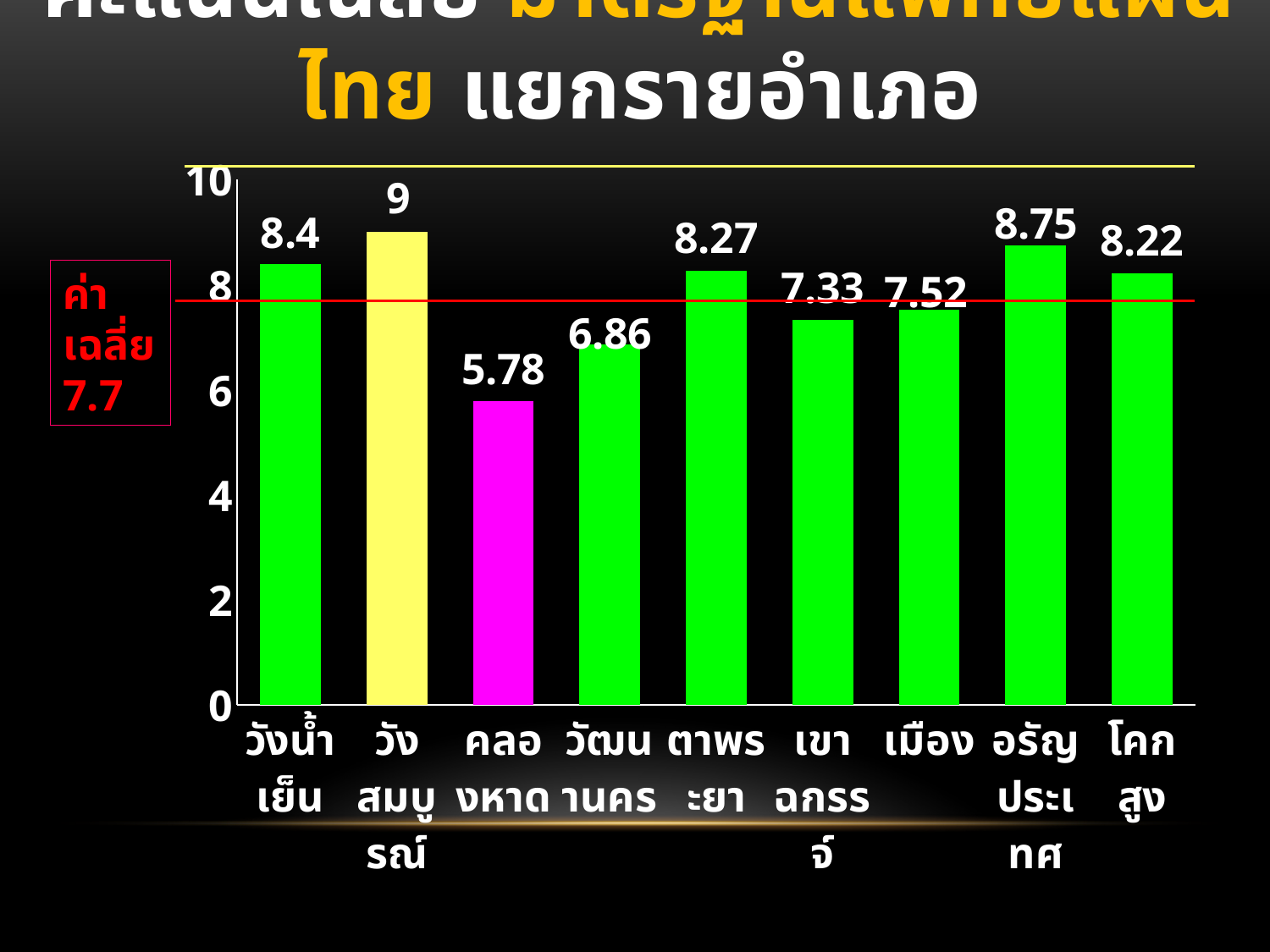
How many districts are shown on the chart? 9 Is the value for วัฒนานคร greater or less than 8? less What kind of chart is shown on the slide? bar chart What average value (ค่าเฉลี่ย) is marked by the red horizontal line? 7.7 What is the difference between the values for วังสมบูรณ์ and คลองหาด? 3.22 Which district has the highest value? วังสมบูรณ์ Which district has the lowest value? คลองหาด What is the value for อรัญประเทศ? 8.75 What is the value for เขาฉกรรจ์? 7.33 Which is larger, the value for วังน้ำเย็น or the value for ตาพระยา? วังน้ำเย็น What is the value for วังสมบูรณ์? 9 What is the value for คลองหาด? 5.78